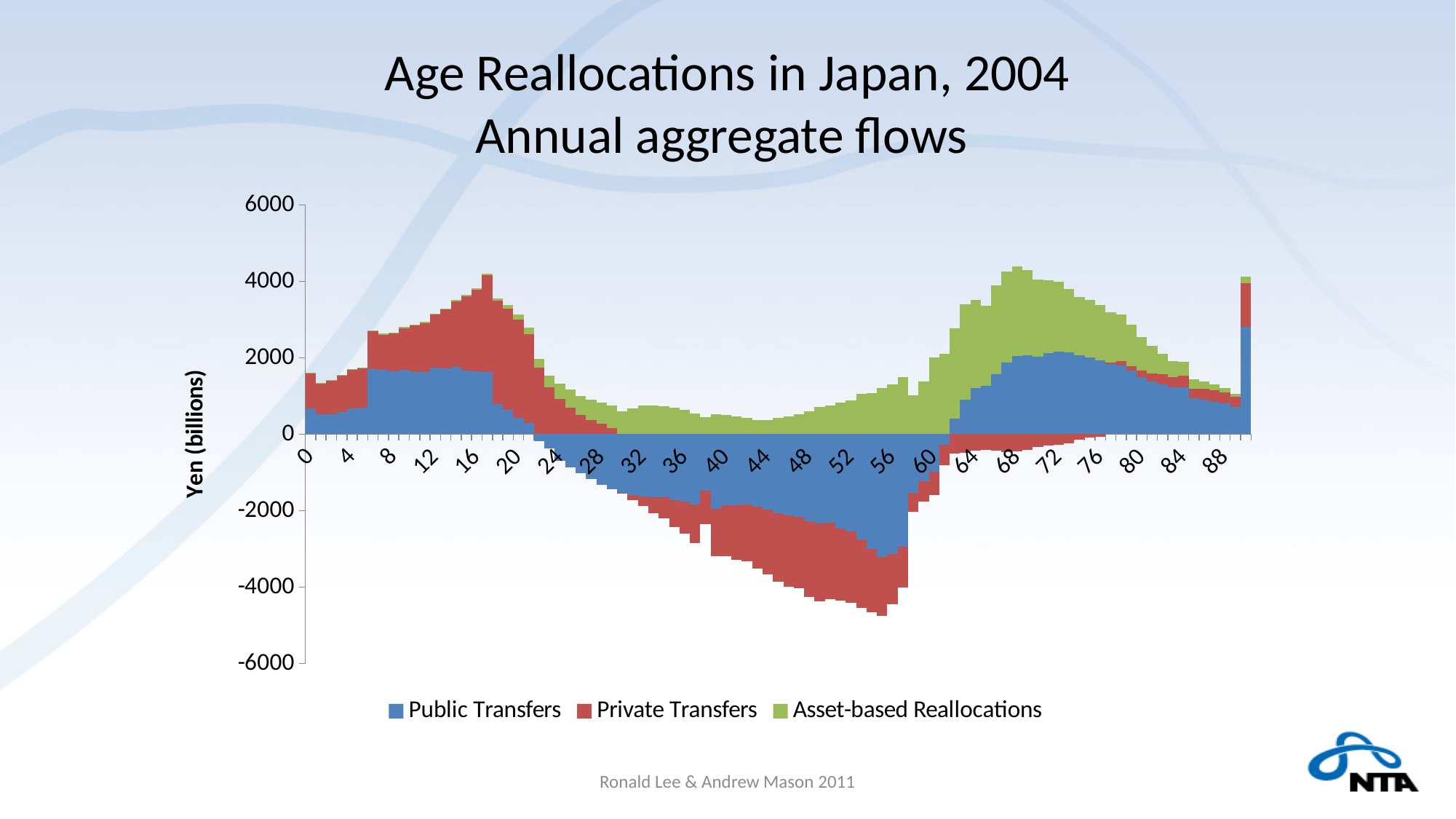
Is the top of the stacked positive values at age 68 greater or less than 4000? greater Is the value for Public Transfers at age 40 greater or less than -1000? less Is the value for Public Transfers at age 56 greater or less than -2000? less Do the Public Transfers values rise or fall from age 60 to age 72? rise Which series is shown in green in the legend? Asset-based Reallocations Do the Public Transfers values rise or fall from age 24 to age 40? fall Do the Public Transfers values rise or fall from age 72 to age 88? fall What is the label on the vertical axis? Yen (billions) How many series does the legend list? 3